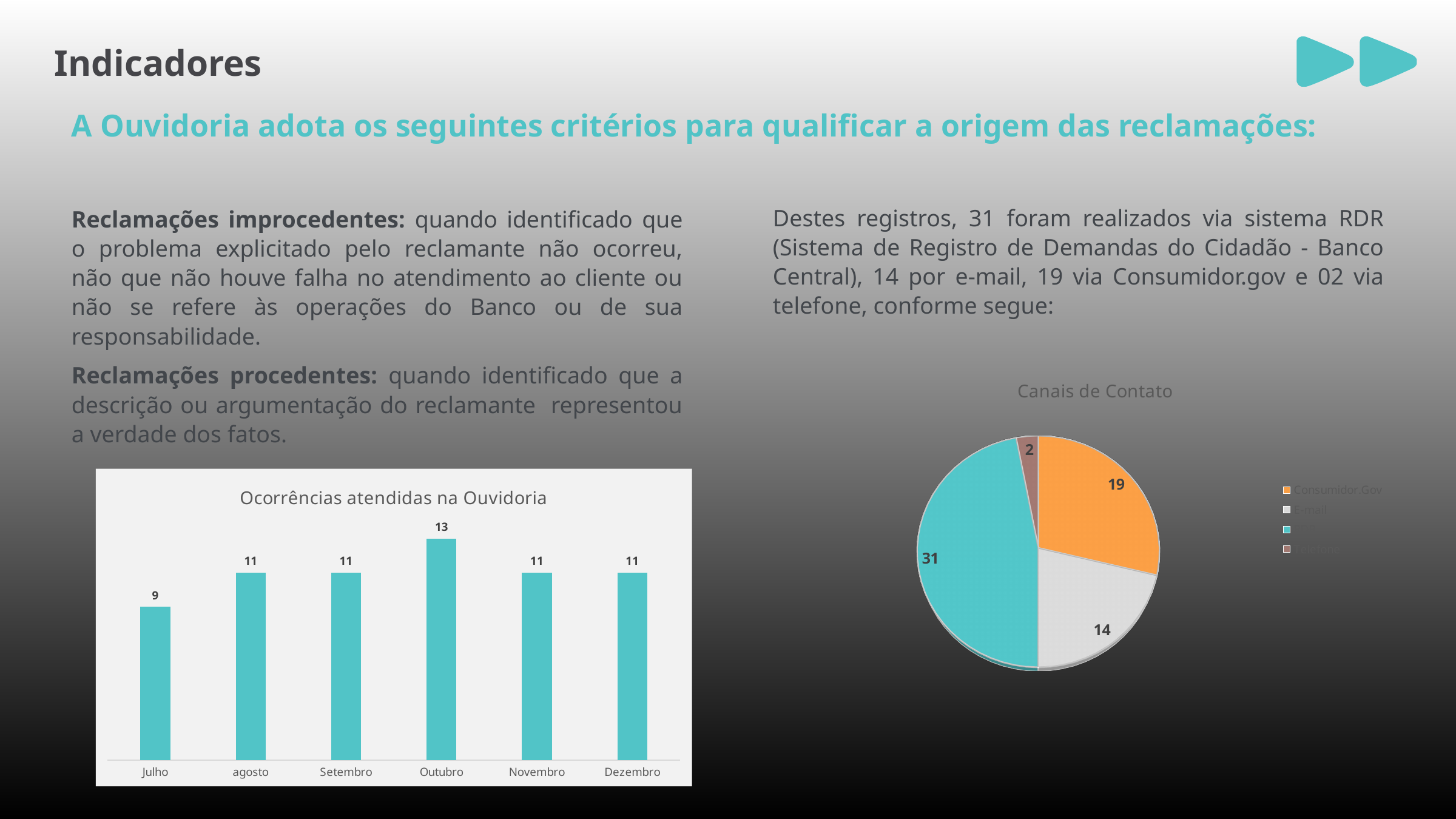
In the 'Canais de Contato' pie chart, what is the value of the smallest slice? 2 In the 'Canais de Contato' pie chart, what is the value of the orange slice? 19 In the 'Ocorrências atendidas na Ouvidoria' chart, is the value for Setembro larger or smaller than the value for Outubro? Smaller In the 'Canais de Contato' pie chart, what is the value of the largest slice? 31 What kind of chart is 'Ocorrências atendidas na Ouvidoria'? Bar chart In the 'Ocorrências atendidas na Ouvidoria' chart, what is the value for Outubro? 13 In the 'Ocorrências atendidas na Ouvidoria' chart, which month has the lowest value? Julho What kind of chart is 'Canais de Contato'? Pie chart In the 'Ocorrências atendidas na Ouvidoria' chart, which month has the highest value? Outubro In the 'Ocorrências atendidas na Ouvidoria' chart, what is the value for Julho? 9 In the 'Ocorrências atendidas na Ouvidoria' chart, how many months are shown on the x axis? 6 In the 'Ocorrências atendidas na Ouvidoria' chart, what is the difference between the values for Outubro and Julho? 4